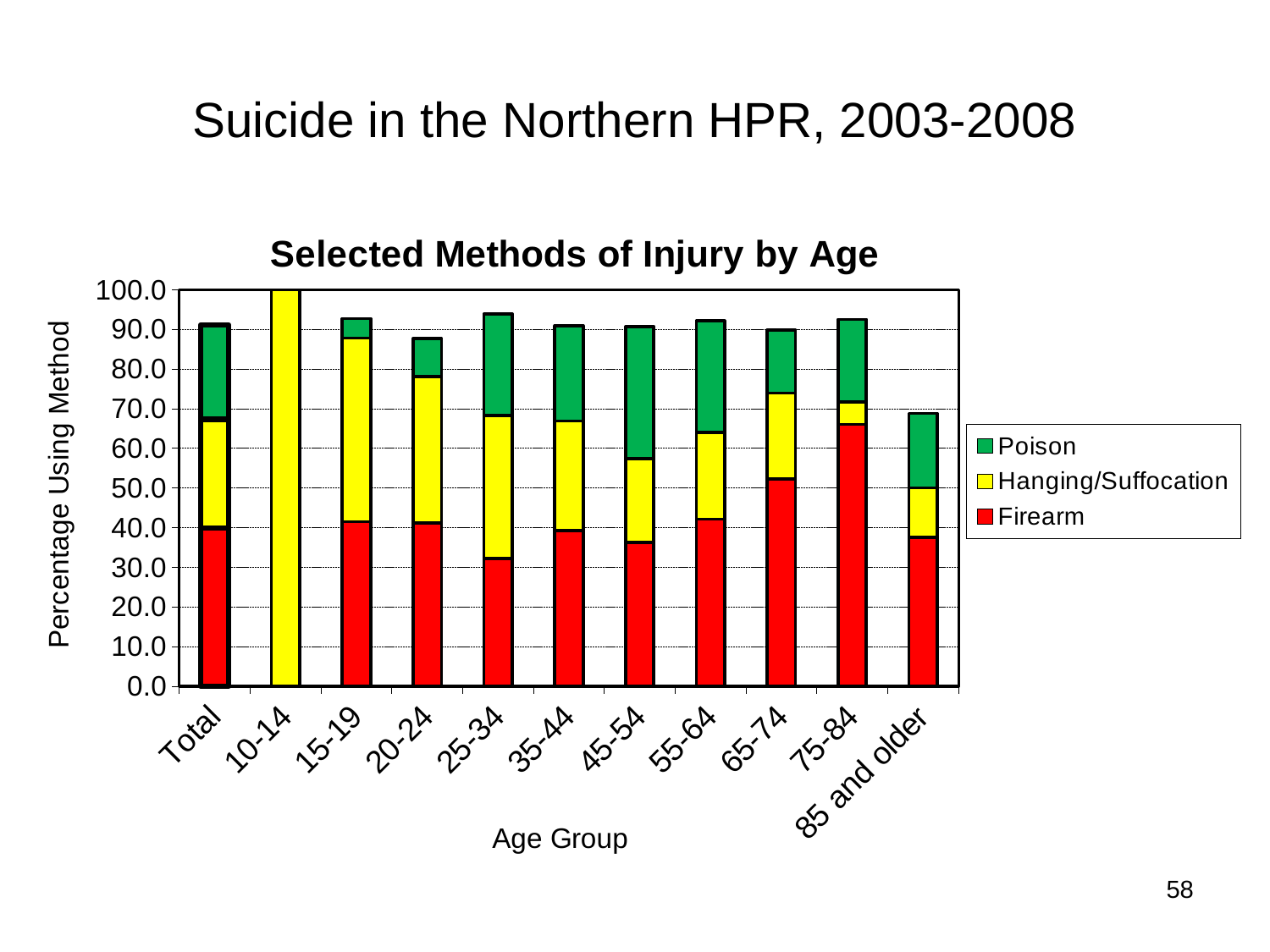
What is the label on the y axis of the chart? Percentage Using Method Which age group has the tallest stacked bar? 10-14 Which age group has the shortest stacked bar? 85 and older What is the title of the chart? Selected Methods of Injury by Age Is the Firearm value for the 25-34 age group greater or less than 40.0? less What is the total height of the stacked bar for the 10-14 age group? 100.0 Which age group has the largest Firearm segment? 75-84 Is the Firearm value for the 65-74 age group greater or less than 50.0? greater How many age group categories are shown on the x axis of the chart? 11 How many series does the chart legend list? 3 Which has the larger Firearm segment, the 65-74 age group or the 45-54 age group? 65-74 What kind of chart is shown on the slide? Stacked bar chart